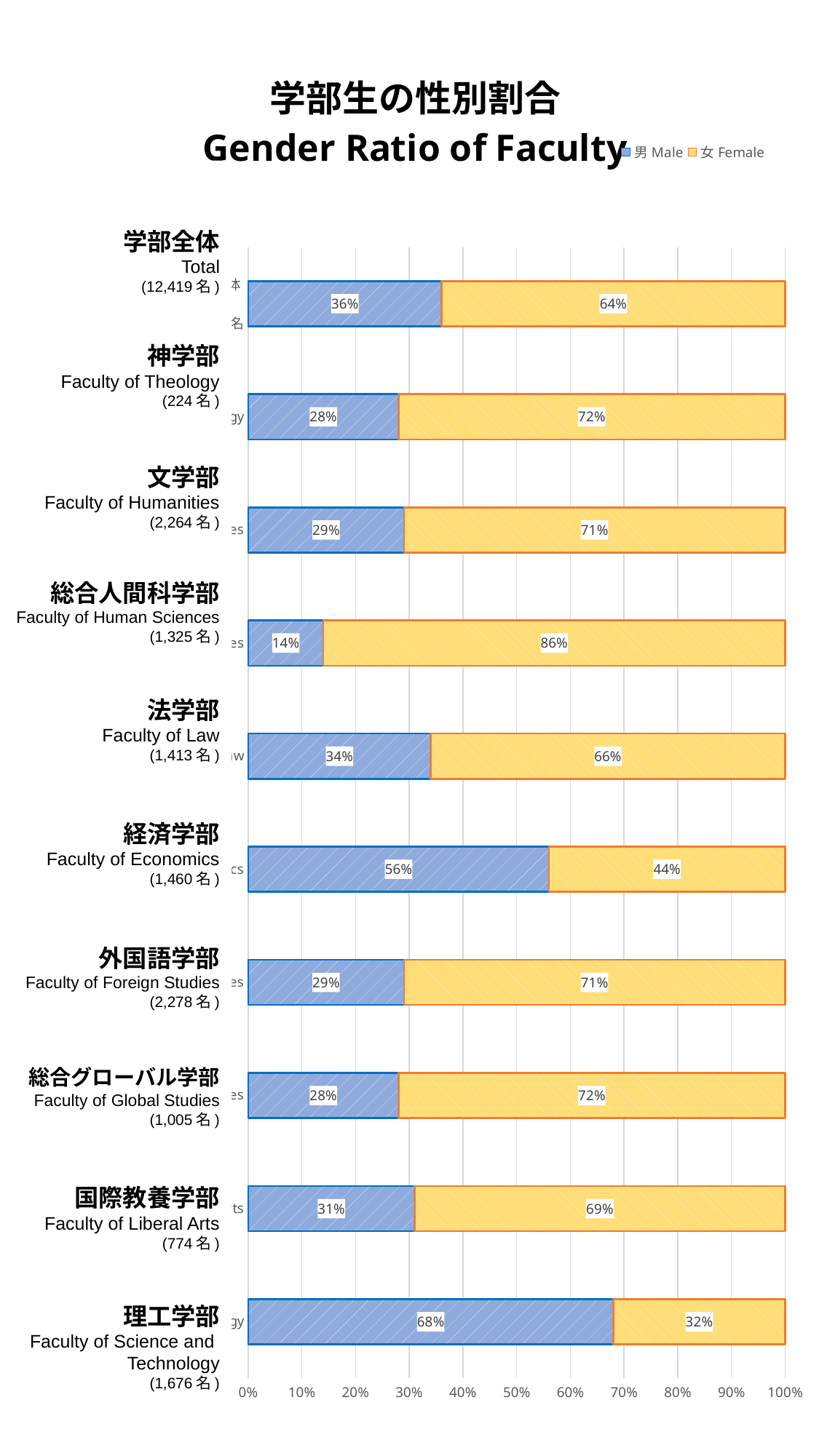
What percentage of the Faculty of Economics is male? 56% What kind of chart is shown on the slide? Stacked bar chart How many faculty categories (including Total) are plotted in the chart? 10 How many series does the legend list? 2 What is the male percentage for the Total (学部全体) bar? 36% What is the difference between the female and male percentages in the Faculty of Law? 32% Which faculty has the lowest male percentage? Faculty of Human Sciences Which faculty has the highest male percentage? Faculty of Science and Technology Which is larger: the male percentage in the Faculty of Liberal Arts or in the Faculty of Theology? Faculty of Liberal Arts Which colour represents 女 Female in the legend? Orange/yellow What is the total of the male and female segments for the Faculty of Foreign Studies bar? 100% What percentage of the Faculty of Human Sciences is female? 86%